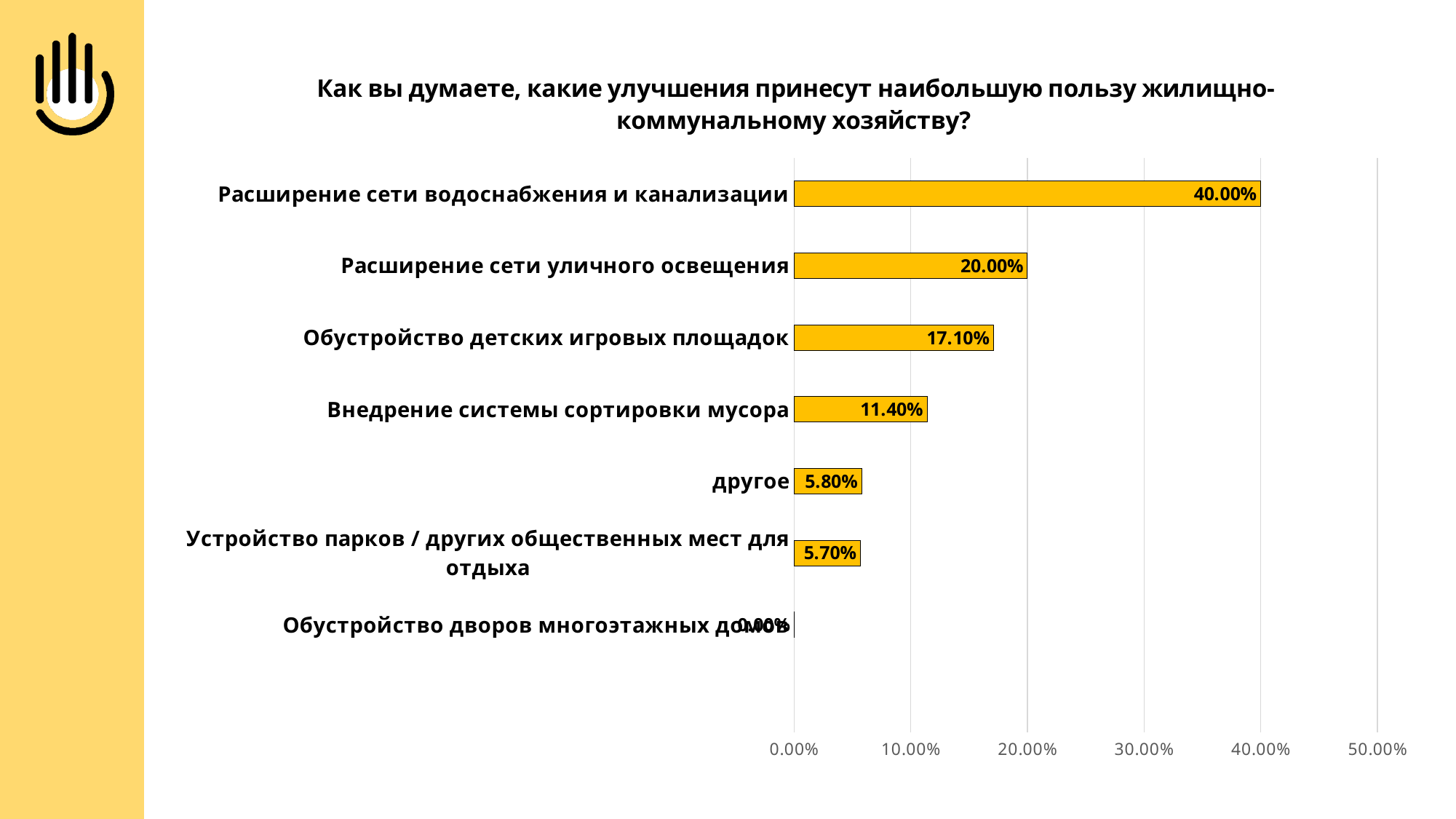
Is the value for "Расширение сети уличного освещения" greater or less than 30.00%? less How many categories are shown in the chart? 7 Which category has the highest value? Расширение сети водоснабжения и канализации What is the value for "Обустройство детских игровых площадок"? 17.10% What is the highest tick value shown on the horizontal axis? 50.00% What is the value for "Внедрение системы сортировки мусора"? 11.40% Which is larger: the value for "Обустройство детских игровых площадок" or the value for "Внедрение системы сортировки мусора"? Обустройство детских игровых площадок What is the value for "Расширение сети водоснабжения и канализации"? 40.00% Which category has the lowest value? Обустройство дворов многоэтажных домов What is the value for "другое"? 5.80% What kind of chart is shown on the slide? bar chart What is the difference between the values for "Расширение сети водоснабжения и канализации" and "Расширение сети уличного освещения"? 20.00%